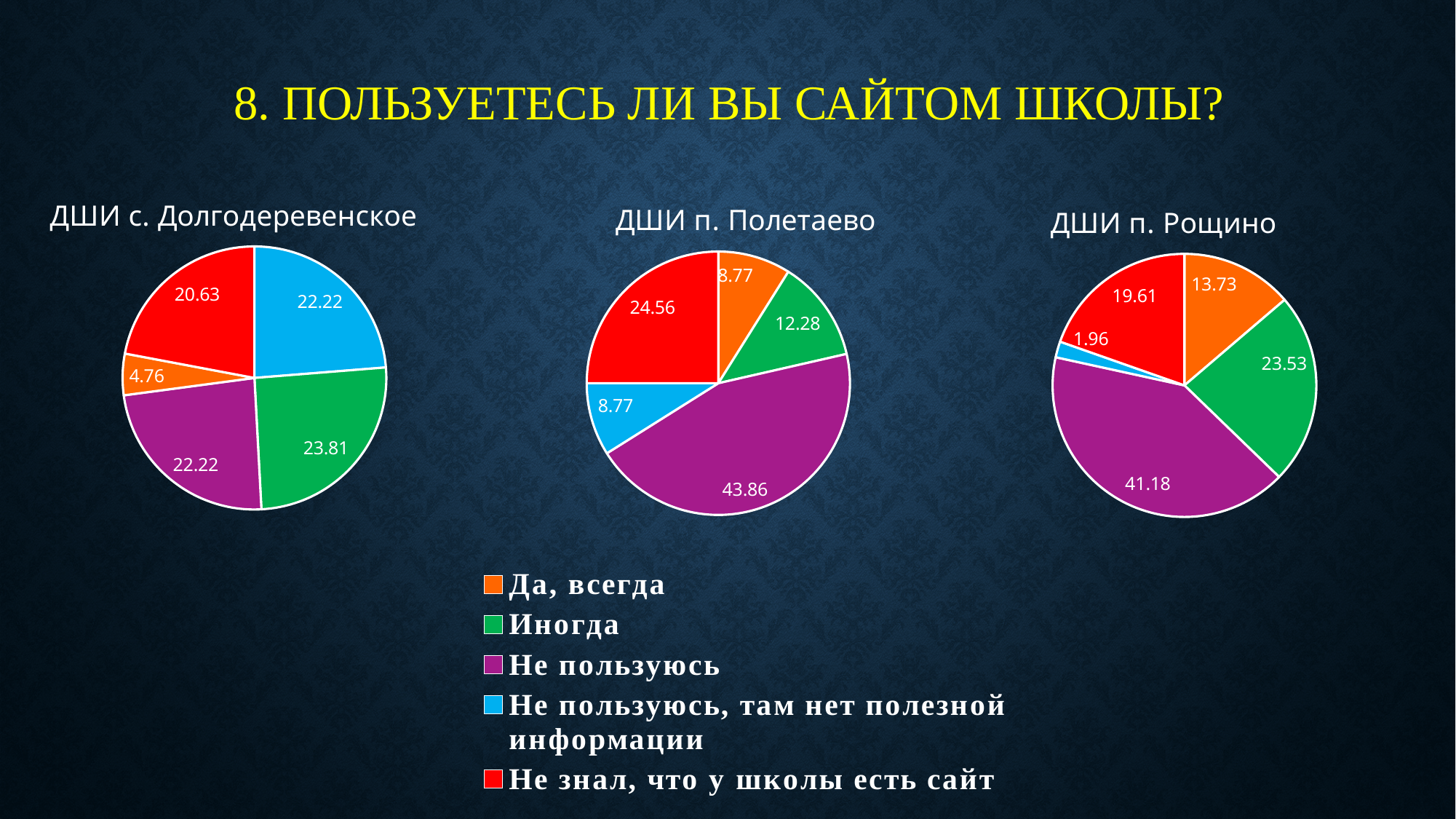
How many slices does the 'ДШИ п. Рощино' chart have? 5 In the 'ДШИ п. Рощино' chart, what is the value for 'Иногда'? 23.53 How many categories does the legend list? 5 In the 'ДШИ п. Полетаево' chart, what is the value for 'Не пользуюсь'? 43.86 Which colour represents 'Не знал, что у школы есть сайт' in the legend? Red In the 'ДШИ п. Рощино' chart, what is the difference between the values for 'Не пользуюсь' and 'Иногда'? 17.65 What type of chart is used on this slide? Pie chart In the 'ДШИ п. Рощино' chart, which category has the smallest slice? Не пользуюсь, там нет полезной информации In the 'ДШИ п. Полетаево' chart, which category has the largest slice? Не пользуюсь In the 'ДШИ п. Полетаево' chart, which is larger: 'Не знал, что у школы есть сайт' or 'Иногда'? Не знал, что у школы есть сайт